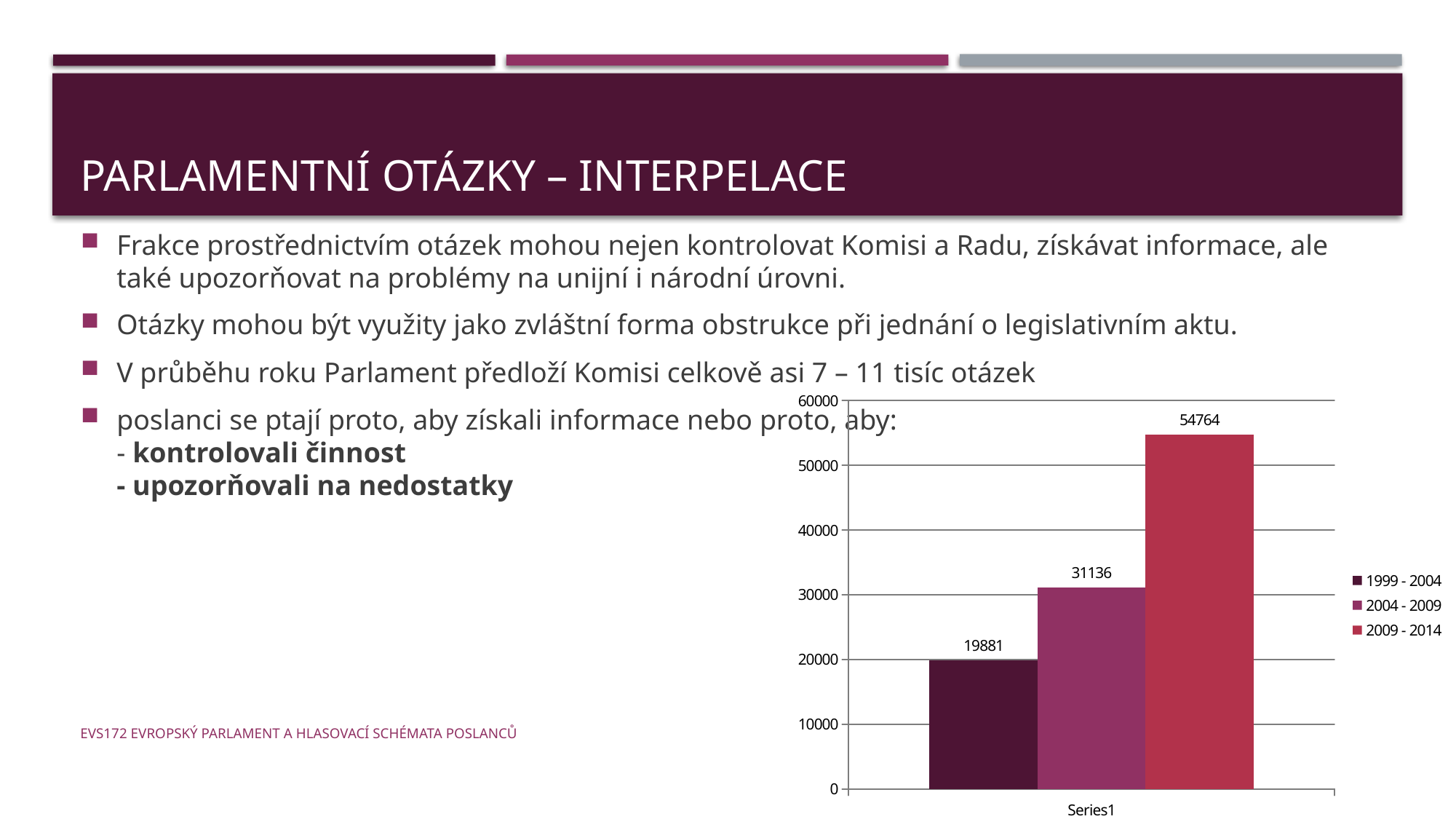
What is the value for the 2009 - 2014 series? 54764 What kind of chart is shown on the slide? bar chart How many series does the legend list? 3 What is the label on the x axis under the bars? Series1 Which is larger, the value for 1999 - 2004 or the value for 2004 - 2009? 2004 - 2009 What is the value for the 2004 - 2009 series? 31136 What is the difference between the 2009 - 2014 value and the 2004 - 2009 value? 23628 What is the value for the 1999 - 2004 series? 19881 What is the difference between the 2004 - 2009 value and the 1999 - 2004 value? 11255 Which series has the highest value? 2009 - 2014 Which series has the lowest value? 1999 - 2004 Is the value for 2009 - 2014 greater or less than 50000? greater